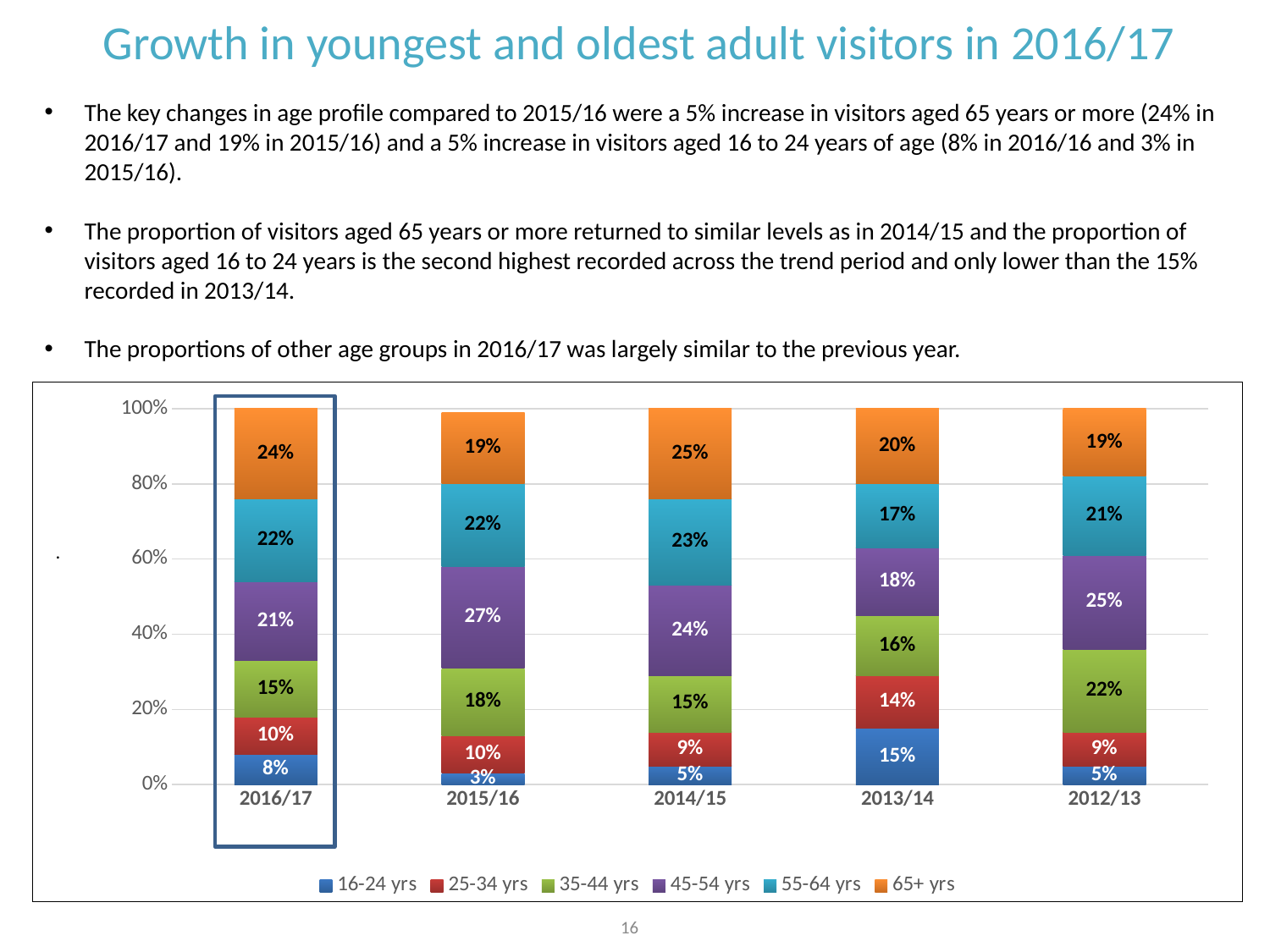
Which year's bar is outlined with a box on the chart? 2016/17 What percentage of visitors were aged 45-54 yrs in 2012/13? 25% How many years are shown on the x axis of the chart? 5 What percentage of visitors were aged 65+ yrs in 2016/17? 24% What is the difference between the 65+ yrs share in 2016/17 and in 2015/16? 5% How many age groups does the legend list? 6 In which year was the share of visitors aged 16-24 yrs highest? 2013/14 In which year was the share of visitors aged 16-24 yrs lowest? 2015/16 Which is larger: the 45-54 yrs share in 2015/16 or in 2016/17? 2015/16 What percentage of visitors were aged 16-24 yrs in 2015/16? 3% What percentage of visitors were aged 55-64 yrs in 2014/15? 23% What type of chart is shown on the slide? Stacked bar chart